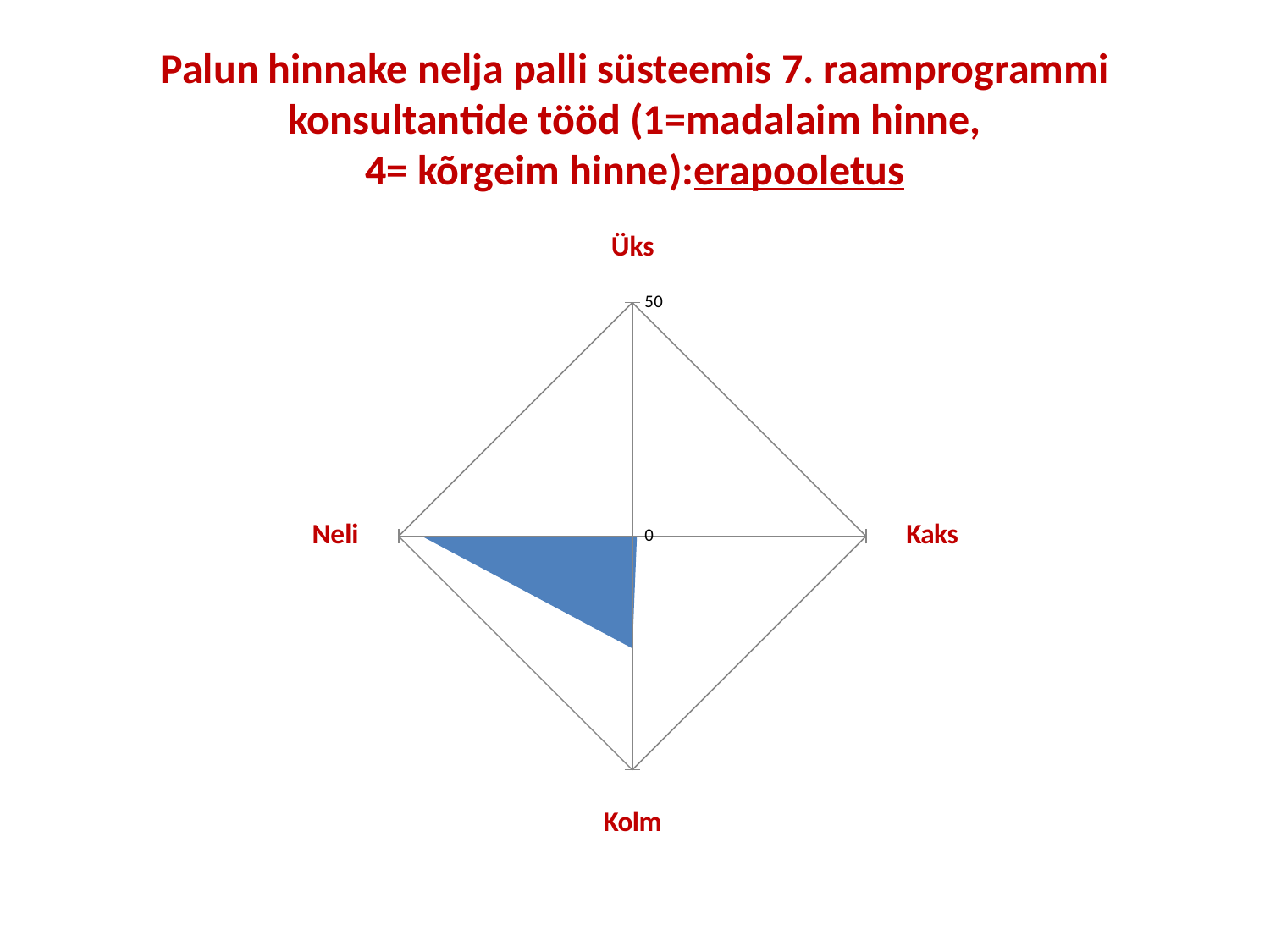
Is the value for Kolm greater or less than 0? greater Is the value for Kolm greater or less than 50? less Is the value for Neli greater or less than 0? greater What colour is the filled data area in the radar chart? Blue Which is larger, the value for Neli or the value for Kolm? Neli Which category label appears at the top of the radar chart? Üks Which category has the highest value in the radar chart? Neli What is the maximum value shown on the radar chart's axis scale? 50 How many categories (axes) does the radar chart have? 4 What kind of chart is shown on the slide? Radar chart Which is larger, the value for Kolm or the value for Kaks? Kolm